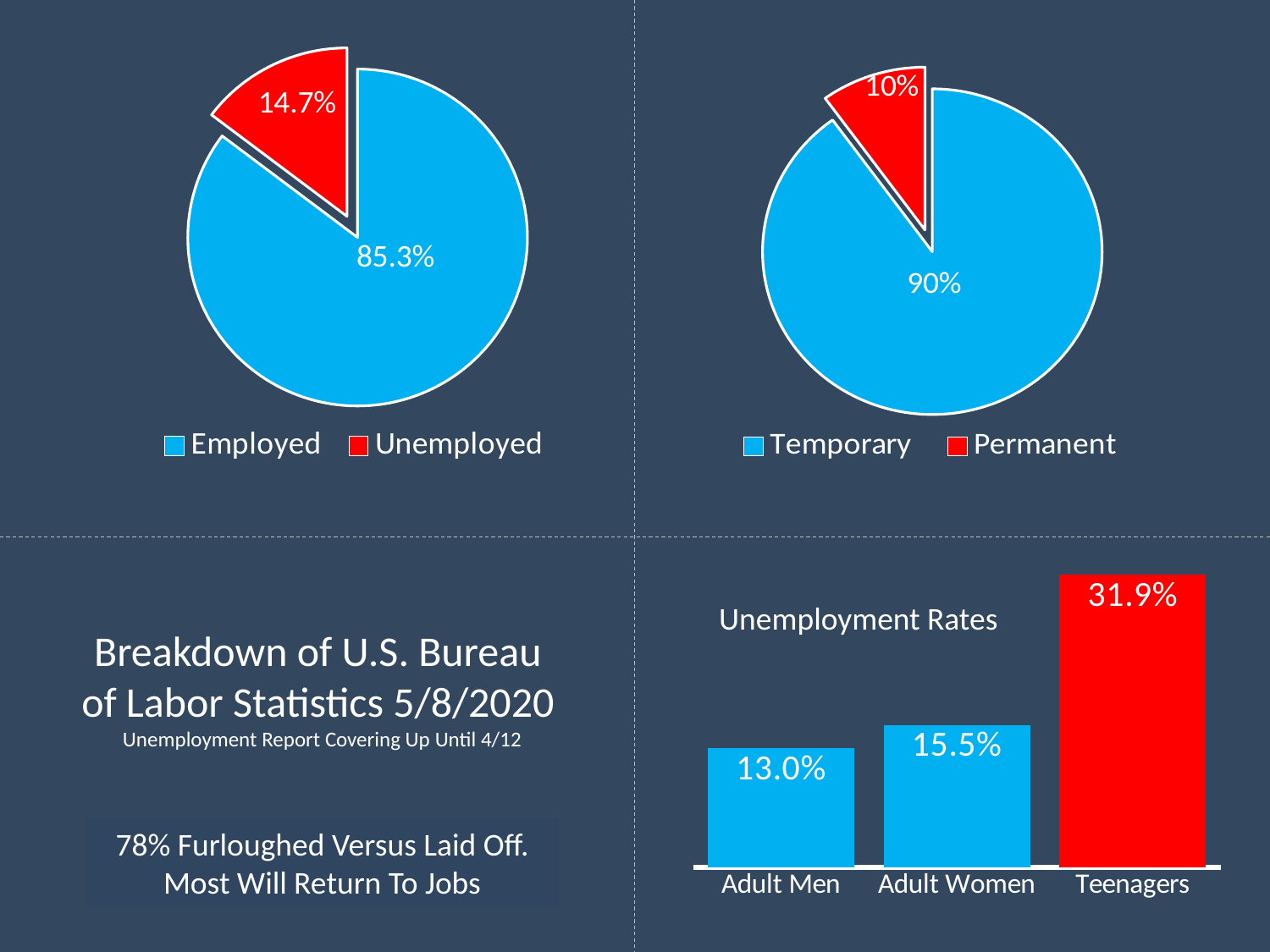
In the Unemployment Rates bar chart, what is the difference between Teenagers and Adult Men? 18.9% In the Unemployment Rates bar chart, how many categories are shown? 3 In the Unemployment Rates bar chart, which category has the highest value? Teenagers In the top-left pie chart (Employed/Unemployed), what share is Unemployed? 14.7% In the Unemployment Rates bar chart, what is the value for Adult Women? 15.5% In the top-left pie chart (Employed/Unemployed), what share is Employed? 85.3% In the top-right pie chart (Temporary/Permanent), what share is Temporary? 90% In the Unemployment Rates bar chart, which category has the lowest value? Adult Men In the top-right pie chart, which legend entry is shown in red? Permanent What kind of chart is the Unemployment Rates chart? Bar chart In the Unemployment Rates bar chart, what is the value for Teenagers? 31.9%